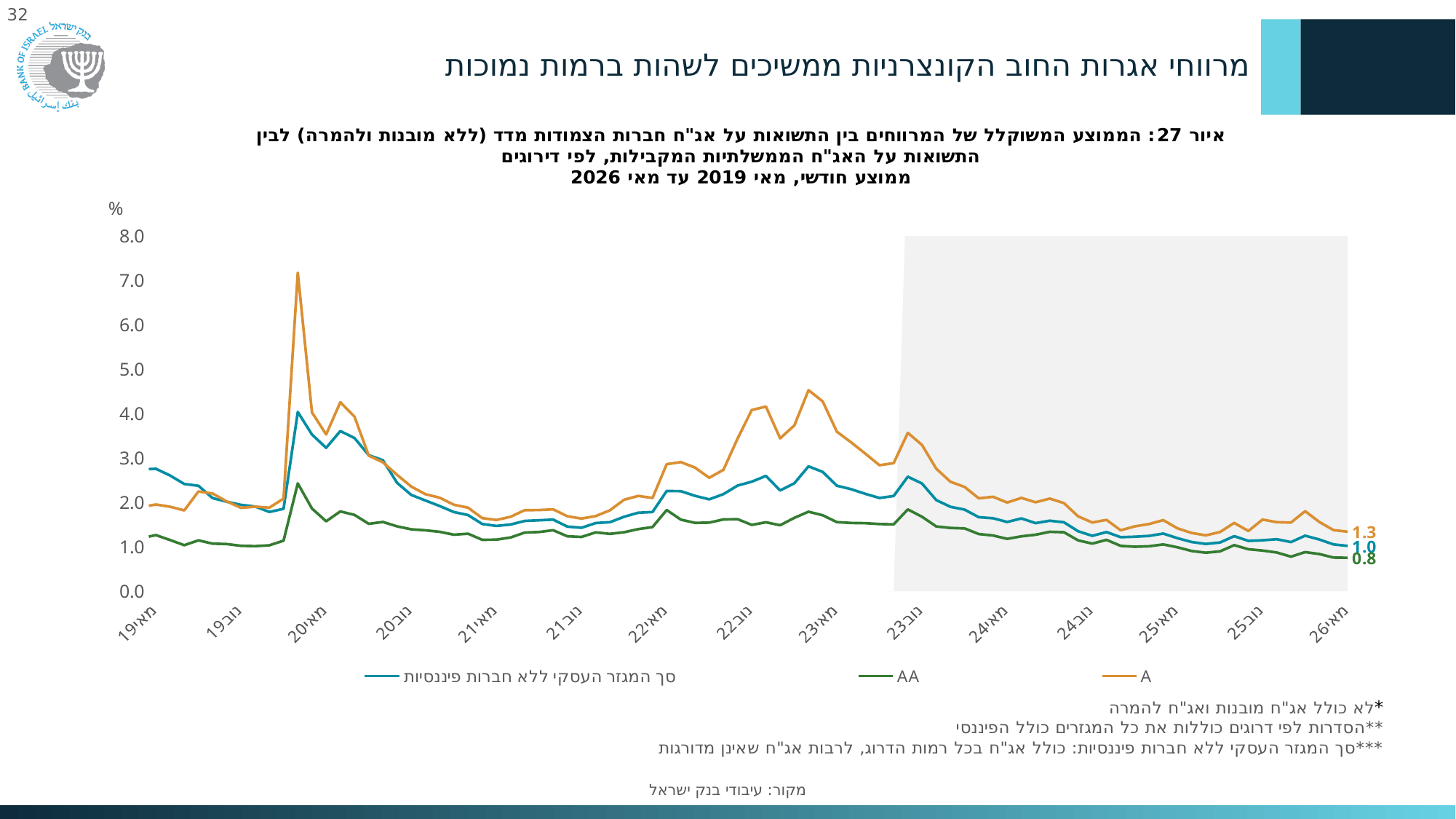
At the end of the chart, which is larger: the A series or the AA series? A What is the difference between the end values of the A series and the AA series? 0.5 From November 2023 to May 2026, does the A series generally rise or fall? fall Is the peak value of the AA series around May 2020 greater or less than 3.0? less What kind of chart is shown on the slide? line chart What is the value labelled at the end of the A series (May 2026)? 1.3 How many series does the legend list? 3 Which series has the highest value at the end of the chart (May 2026)? A Is the peak value of the A series around May 2020 greater or less than 6.0? greater What is the value labelled at the end of the 'סך המגזר העסקי ללא חברות פיננסיות' series (May 2026)? 1.0 Which series has the lowest value at the end of the chart (May 2026)? AA What is the value labelled at the end of the AA series (May 2026)? 0.8